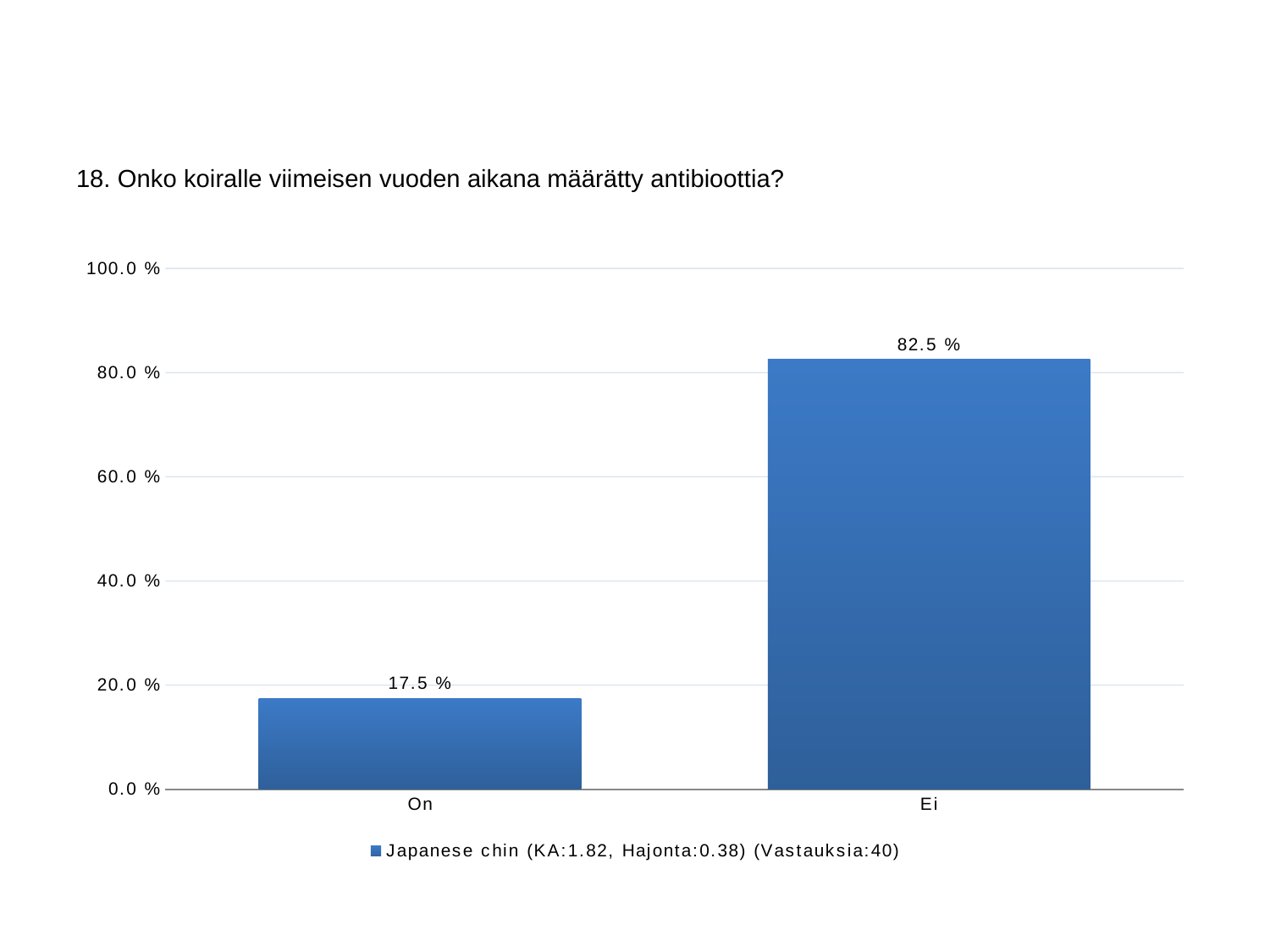
Which category has the highest value? Ei What is the value for "On"? 17.5 % Is the value for "On" greater or less than 20.0 %? less Which category has the lowest value? On What is the value for "Ei"? 82.5 % How many responses (Vastauksia) does the legend entry report? 40 Which is larger, the value for "On" or the value for "Ei"? Ei What is the difference between the values for "Ei" and "On"? 65.0 % How many series does the legend list? 1 What kind of chart is shown on the slide? bar chart Is the value for "Ei" greater or less than 80.0 %? greater How many categories are shown on the x axis? 2